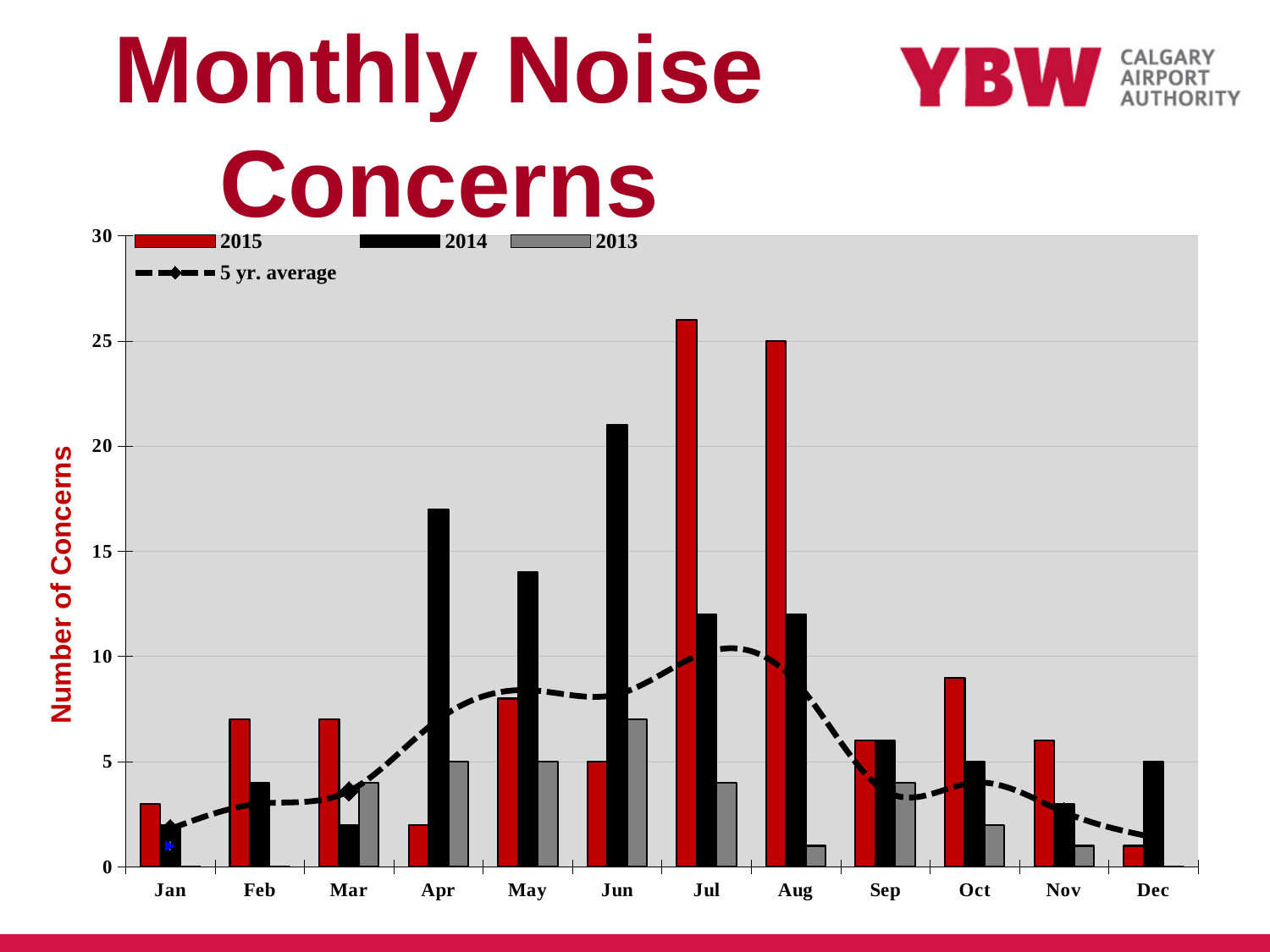
Is the value of the 2014 bar for Apr greater or less than 15? greater Is the value of the 2015 bar for Jul greater or less than 25? greater Which month has the highest 2015 bar? Jul Is the value of the 2014 bar for Jun greater or less than 20? greater What kind of chart is shown on the slide? Combination bar and line chart Which month has the highest 2014 bar? Jun How many months are shown along the x axis? 12 Does the 5 yr. average line rise or fall from Aug to Dec? Fall How many series does the legend list? 4 What is the label on the y axis? Number of Concerns In Apr, which is larger, the 2014 bar or the 2015 bar? 2014 What is the value of the 2015 bar for Aug? 25